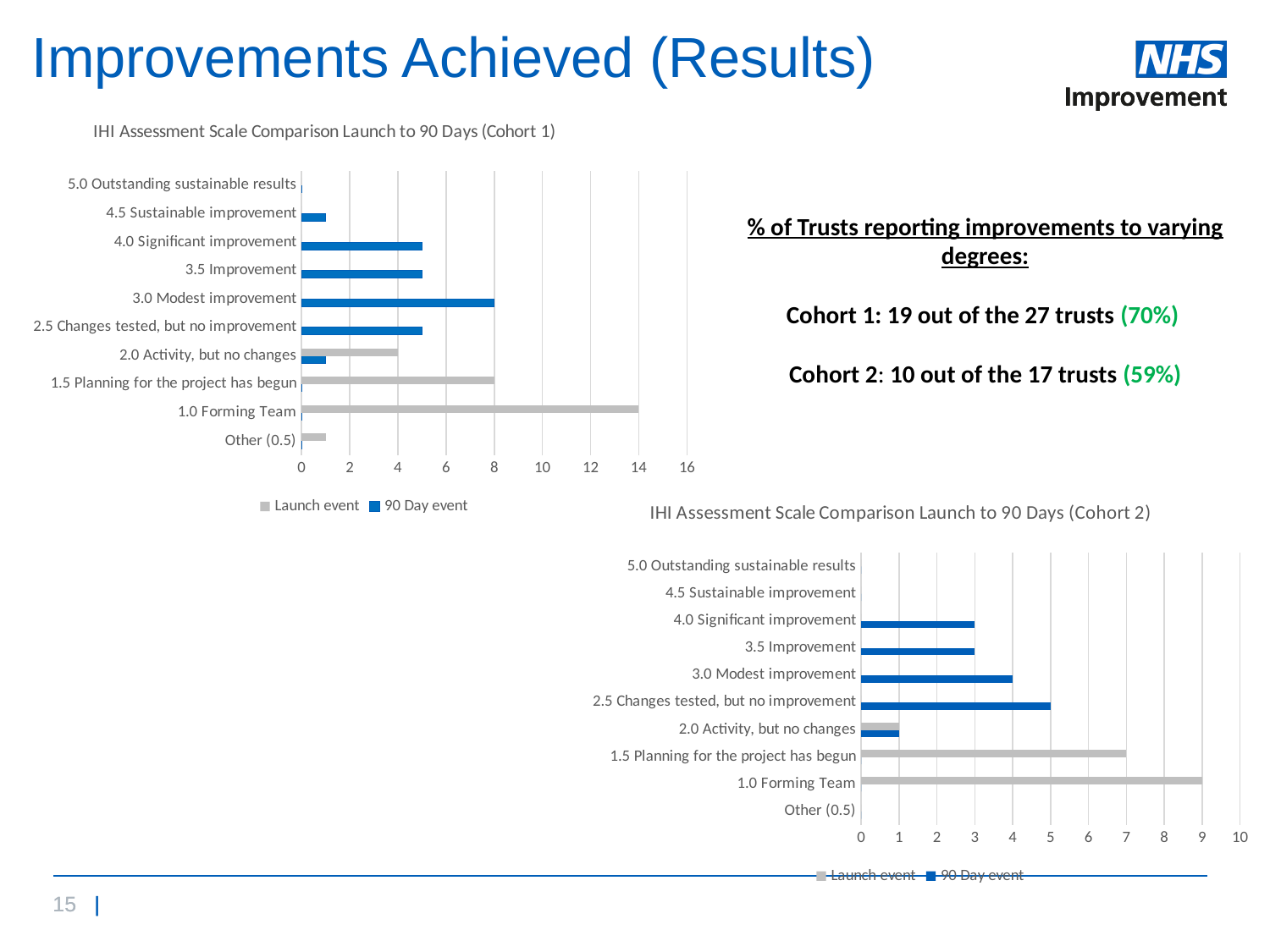
In the Cohort 1 chart, which category has the highest Launch event value? 1.0 Forming Team In the Cohort 2 chart, what is the 90 Day event value for '3.0 Modest improvement'? 4 How many categories are listed on the vertical axis of the Cohort 2 chart? 10 In the Cohort 2 chart, what is the 90 Day event value for '2.5 Changes tested, but no improvement'? 5 In the Cohort 1 chart, what is the Launch event value for '1.0 Forming Team'? 14 In the Cohort 2 chart, which has the larger 90 Day event value: '2.5 Changes tested, but no improvement' or '3.0 Modest improvement'? 2.5 Changes tested, but no improvement In the Cohort 1 chart, what is the 90 Day event value for '3.0 Modest improvement'? 8 In the Cohort 1 chart, is the 90 Day event value for '4.0 Significant improvement' greater or less than 4? greater What type of chart is the 'IHI Assessment Scale Comparison Launch to 90 Days (Cohort 1)' chart? Bar chart How many series does the legend of the Cohort 1 chart list? 2 In the Cohort 2 chart, what is the difference between the Launch event values for '1.0 Forming Team' and '1.5 Planning for the project has begun'? 2 In the Cohort 2 chart, what is the Launch event value for '1.0 Forming Team'? 9